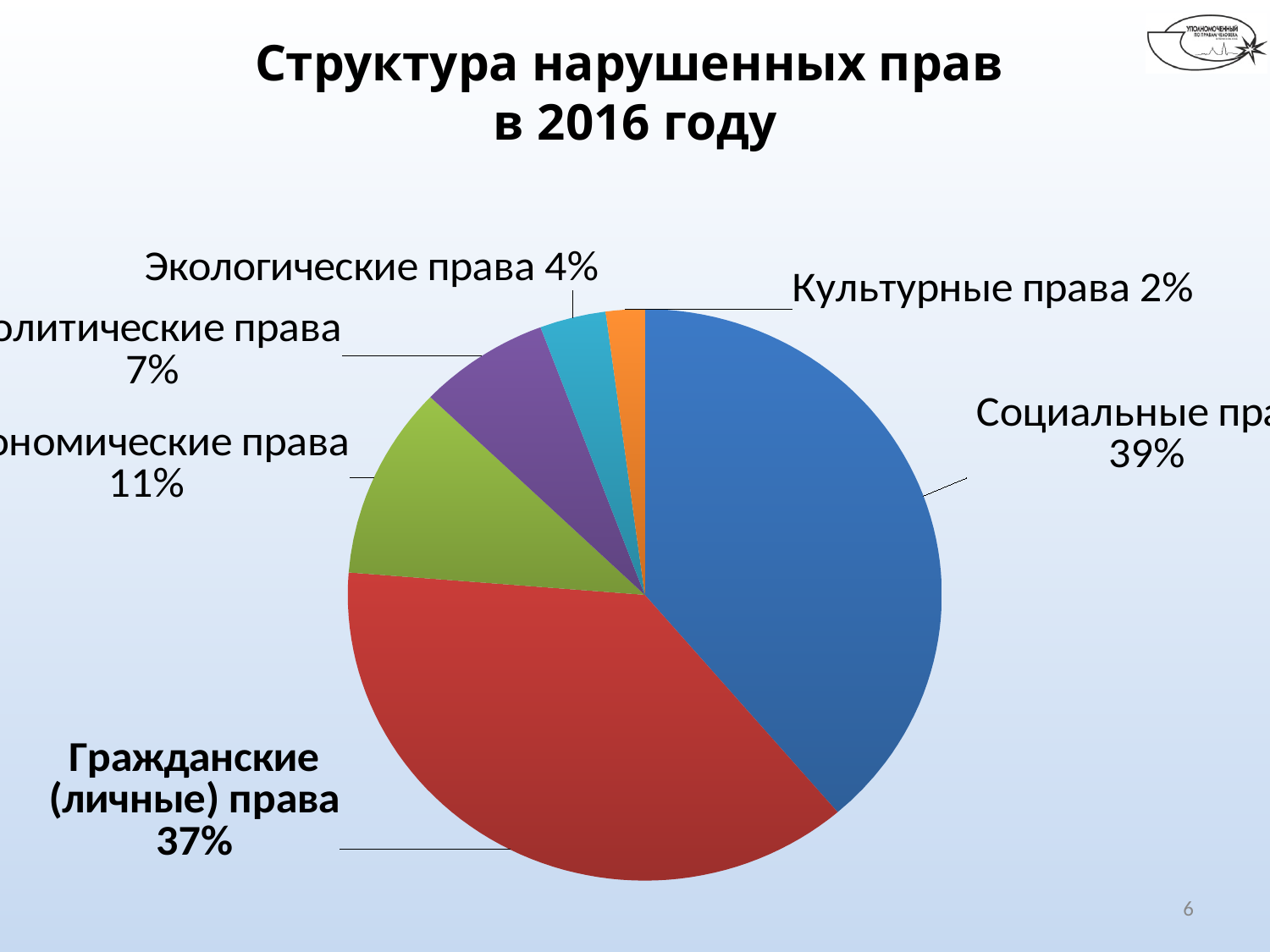
What share of the pie does Социальные права take? 39% Which category has the largest share of the pie? Социальные права What is the difference in percentage points between Социальные права and Гражданские (личные) права? 2% What is the title of the chart? Структура нарушенных прав в 2016 году Which category has the smallest share of the pie? Культурные права Which slice is larger: Экологические права or Культурные права? Экологические права What is the difference in percentage points between Гражданские (личные) права and Экологические права? 33% What kind of chart is shown on the slide? Pie chart How many slices does the pie chart have? 6 What percentage is shown for Экологические права? 4% What percentage is shown for Культурные права? 2% What percentage is shown for Гражданские (личные) права? 37%